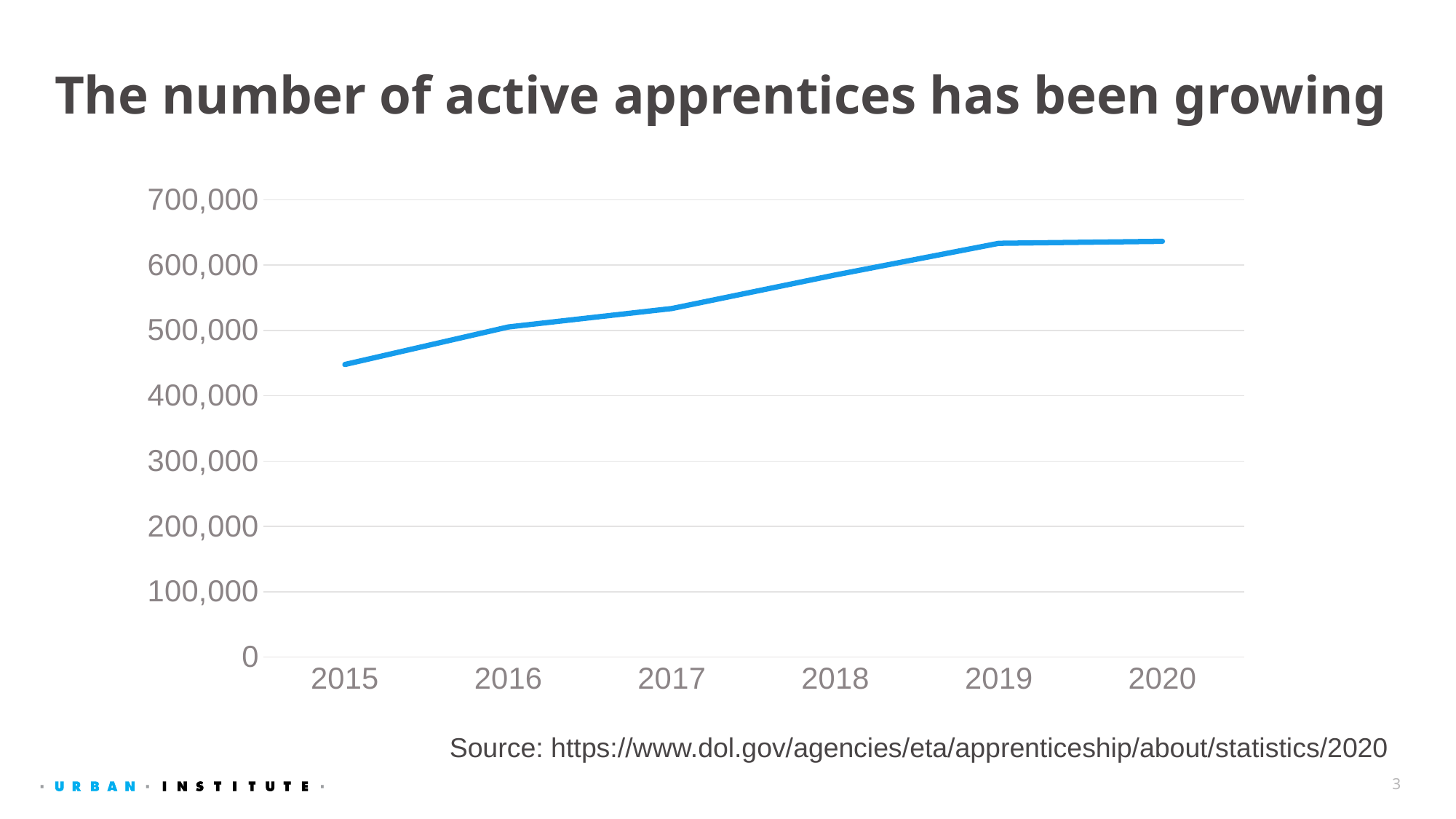
What kind of chart is shown on the slide? line chart Which year has the larger value, 2015 or 2017? 2017 Which year has the lowest number of active apprentices? 2015 What is the title of the slide? The number of active apprentices has been growing Is the value for 2018 greater or less than 500,000? greater Is the value for 2017 greater or less than 500,000? greater Do the values rise or fall from 2015 to 2020? rise Is the value for 2015 greater or less than 500,000? less What colour is the plotted line? blue How many years are plotted on the x axis? 6